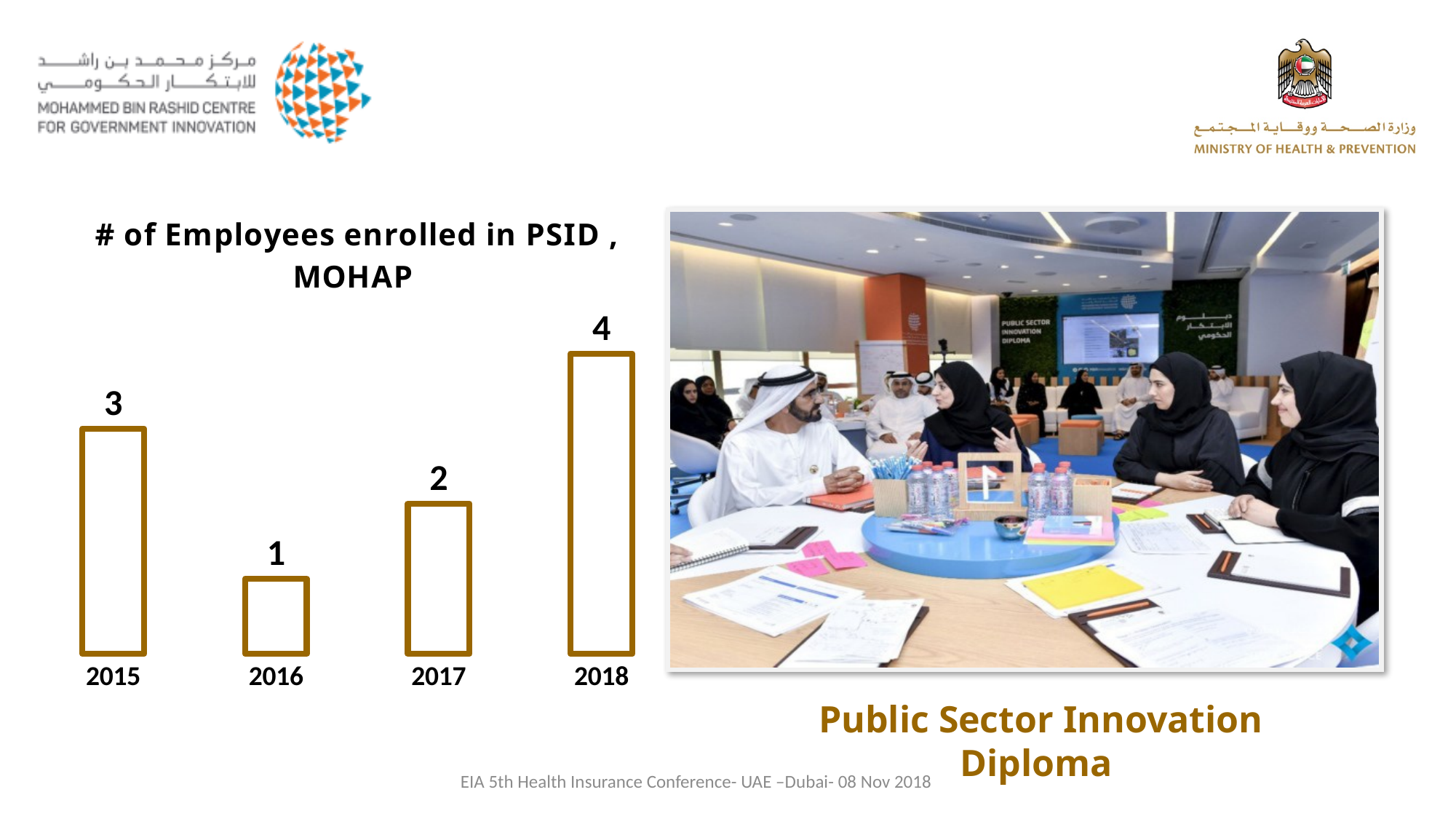
How many employees were enrolled in PSID in 2015? 3 What type of chart is used to show the number of employees enrolled in PSID? Bar chart What is the difference between the number of employees enrolled in 2018 and in 2016? 3 How many years are shown on the chart? 4 How many employees were enrolled in PSID in 2018? 4 Which year had the highest number of employees enrolled in PSID? 2018 How many employees were enrolled in PSID in 2017? 2 Which year had the lowest number of employees enrolled in PSID? 2016 How many employees were enrolled in PSID in 2016? 1 Which year had more employees enrolled in PSID, 2015 or 2017? 2015 What is the title of the chart? # of Employees enrolled in PSID , MOHAP Do the values rise or fall from 2016 to 2018? Rise